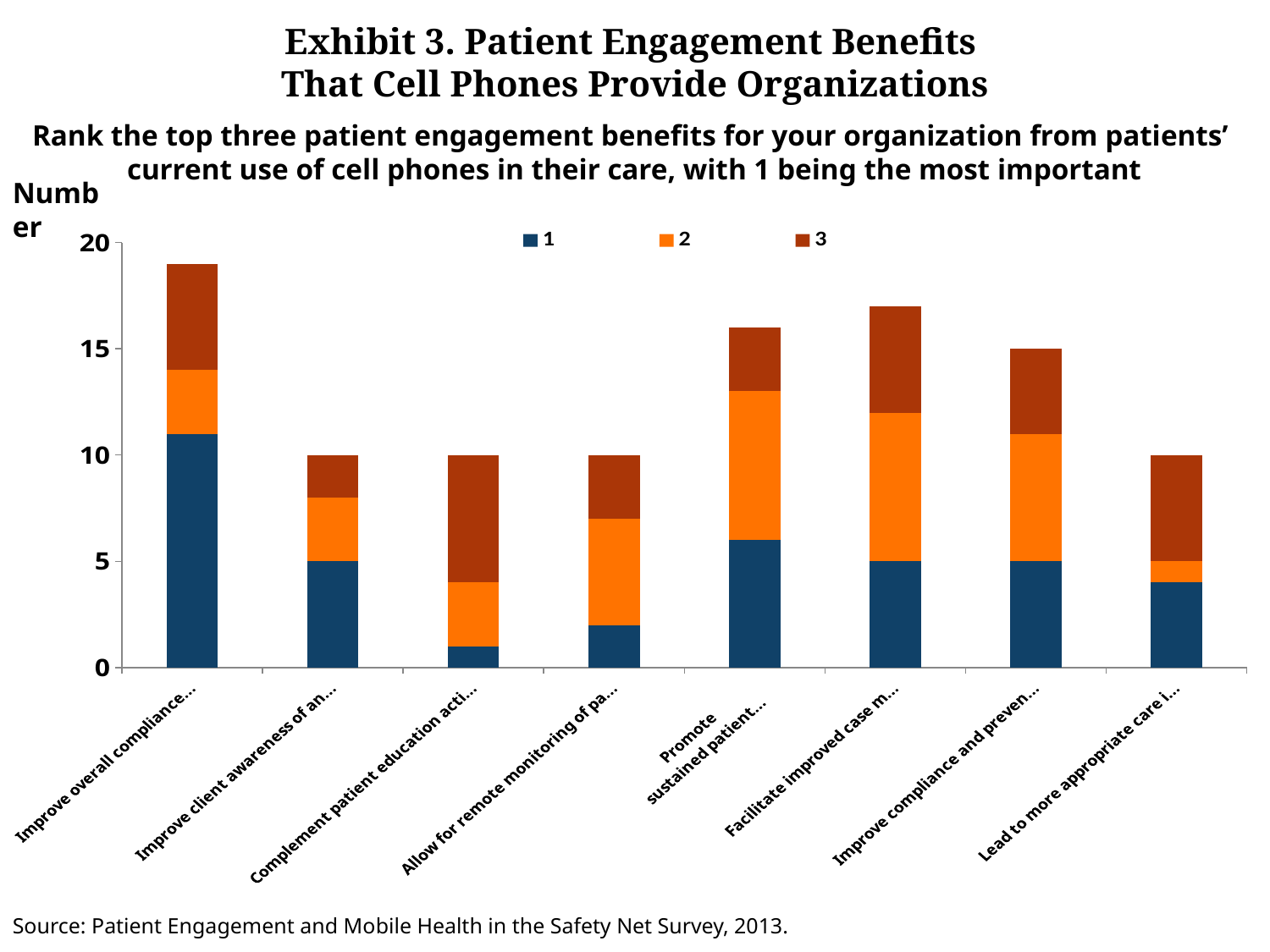
Which category has the tallest stacked bar overall? Improve overall compliance... Is the total for 'Facilitate improved case m...' greater or less than 15? greater How many categories (bars) are plotted on the x axis? 8 What is the total height of the stacked bar for 'Improve client awareness of an...'? 10 What is the total height of the stacked bar for 'Improve compliance and preven...'? 15 What is the value of series 1 for 'Improve client awareness of an...'? 5 What kind of chart is shown on the slide? Stacked bar chart What label is shown on the vertical axis? Number Is the series 1 value for 'Improve overall compliance...' greater or less than 10? greater How many series does the legend list? 3 Which has the taller stacked bar: 'Improve overall compliance...' or 'Lead to more appropriate care i...'? Improve overall compliance... Which category has the smallest segment for series 1? Complement patient education acti...